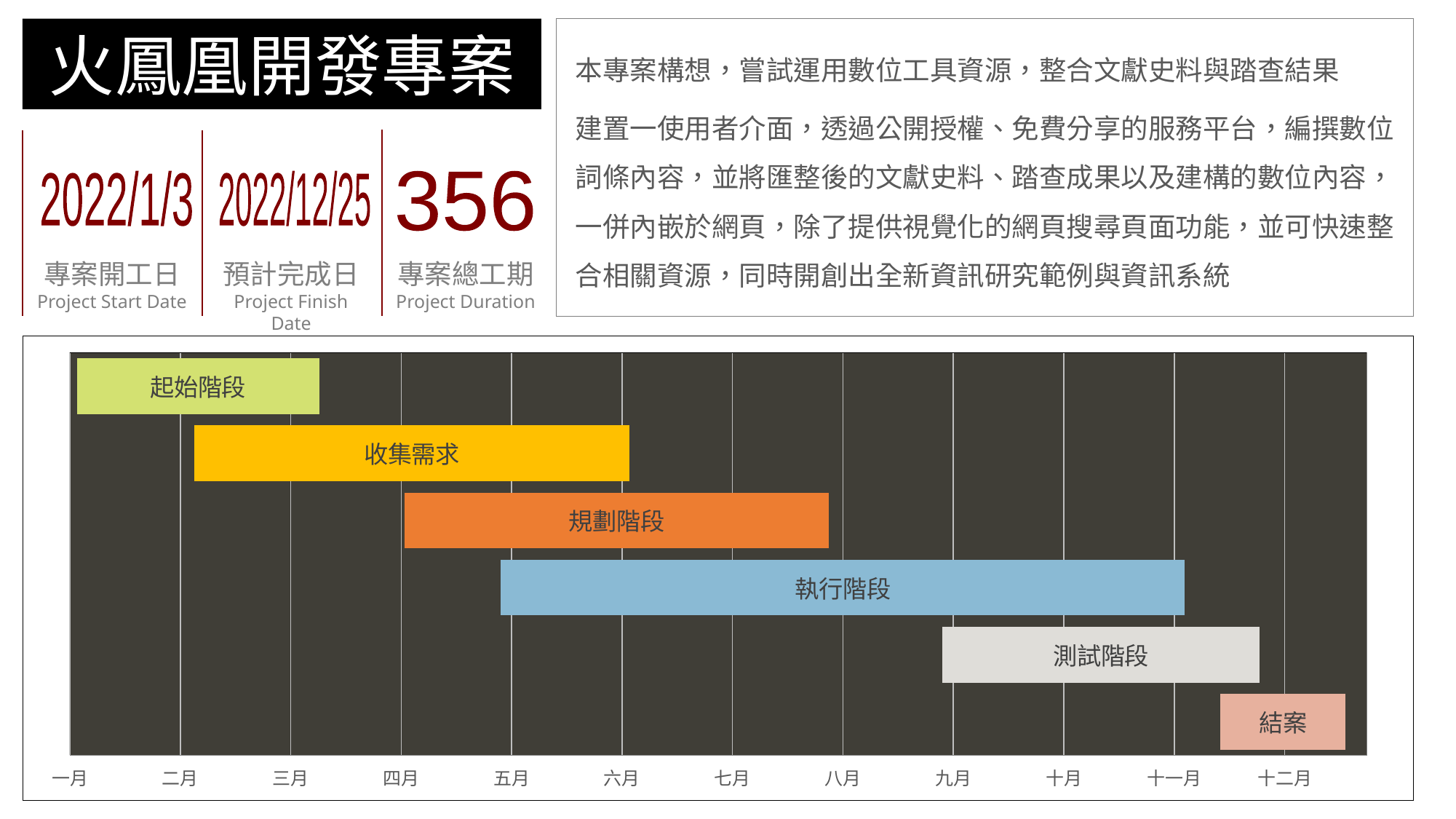
Which phase has the longest bar in the chart? 執行階段 Does the 起始階段 bar end before or after the 四月 gridline? before Which phase's bar is directly below the 規劃階段 bar in the chart? 執行階段 Which phase has the shortest bar in the chart? 結案 Which bar is longer, 起始階段 or 收集需求? 收集需求 Which phase ends latest in the chart? 結案 How many project phases are plotted as bars in the chart? 6 What kind of chart is shown at the bottom of the slide? bar chart How many month labels are shown along the x axis of the chart? 12 Which phase starts earliest in the chart? 起始階段 Which bar is longer, 執行階段 or 測試階段? 執行階段 Does the 結案 bar begin before or after the 十一月 gridline? after